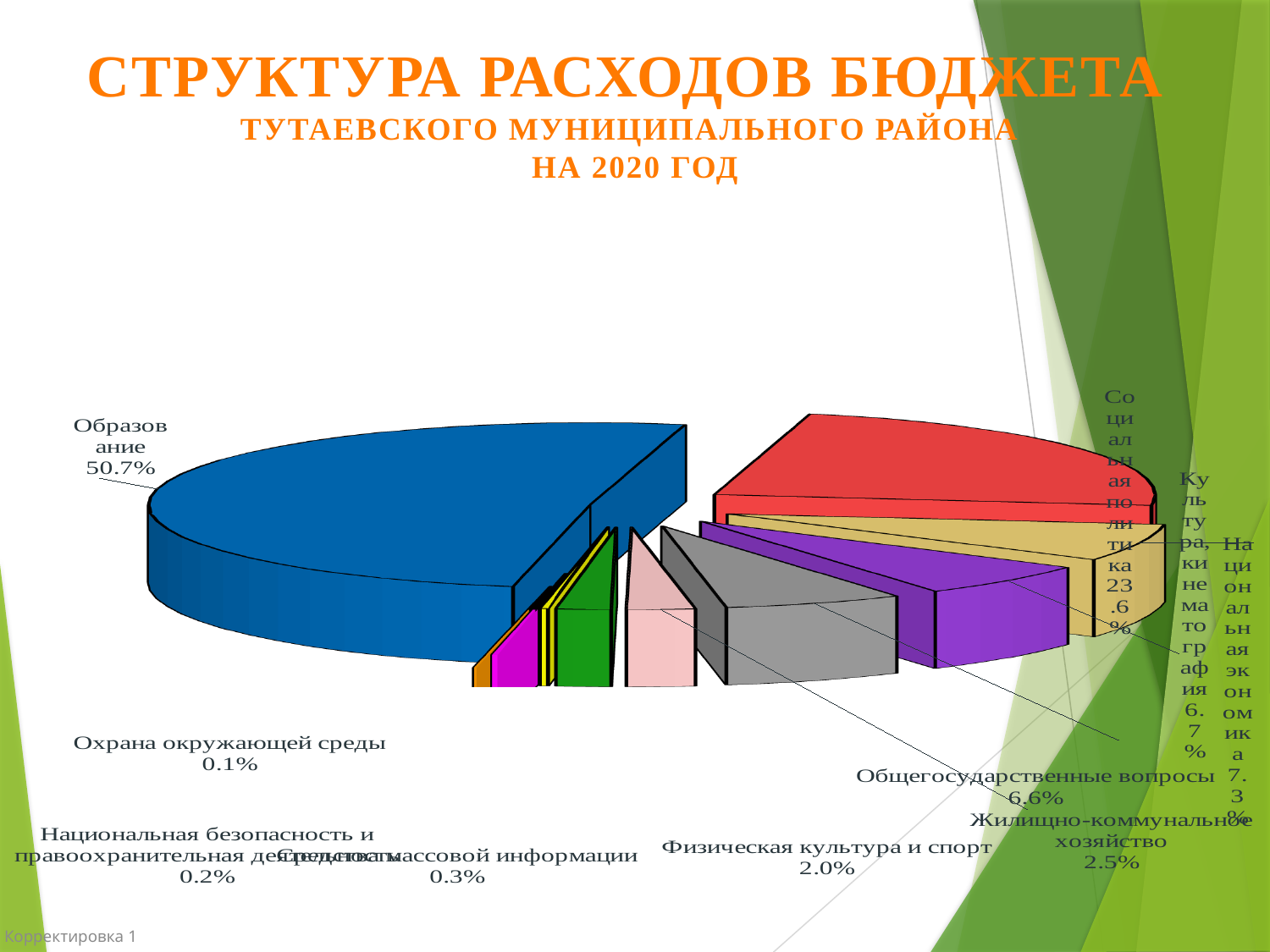
What is the value for Охрана окружающей среды? 0.1% What percentage is shown for Общегосударственные вопросы? 6.6% Which category has the smallest share of the budget expenditure? Охрана окружающей среды What is the value for Жилищно-коммунальное хозяйство? 2.5% What is the difference between the shares of Образование and Социальная политика? 27.1% What share is shown for Физическая культура и спорт? 2.0% What share of the budget expenditure goes to Образование? 50.7% What kind of chart is shown on the slide? pie chart How many categories are shown in the pie chart? 10 Which is larger, the share for Национальная экономика or for Культура, кинематография? Национальная экономика Which category has the largest share of the budget expenditure? Образование What is the value shown for Социальная политика? 23.6%